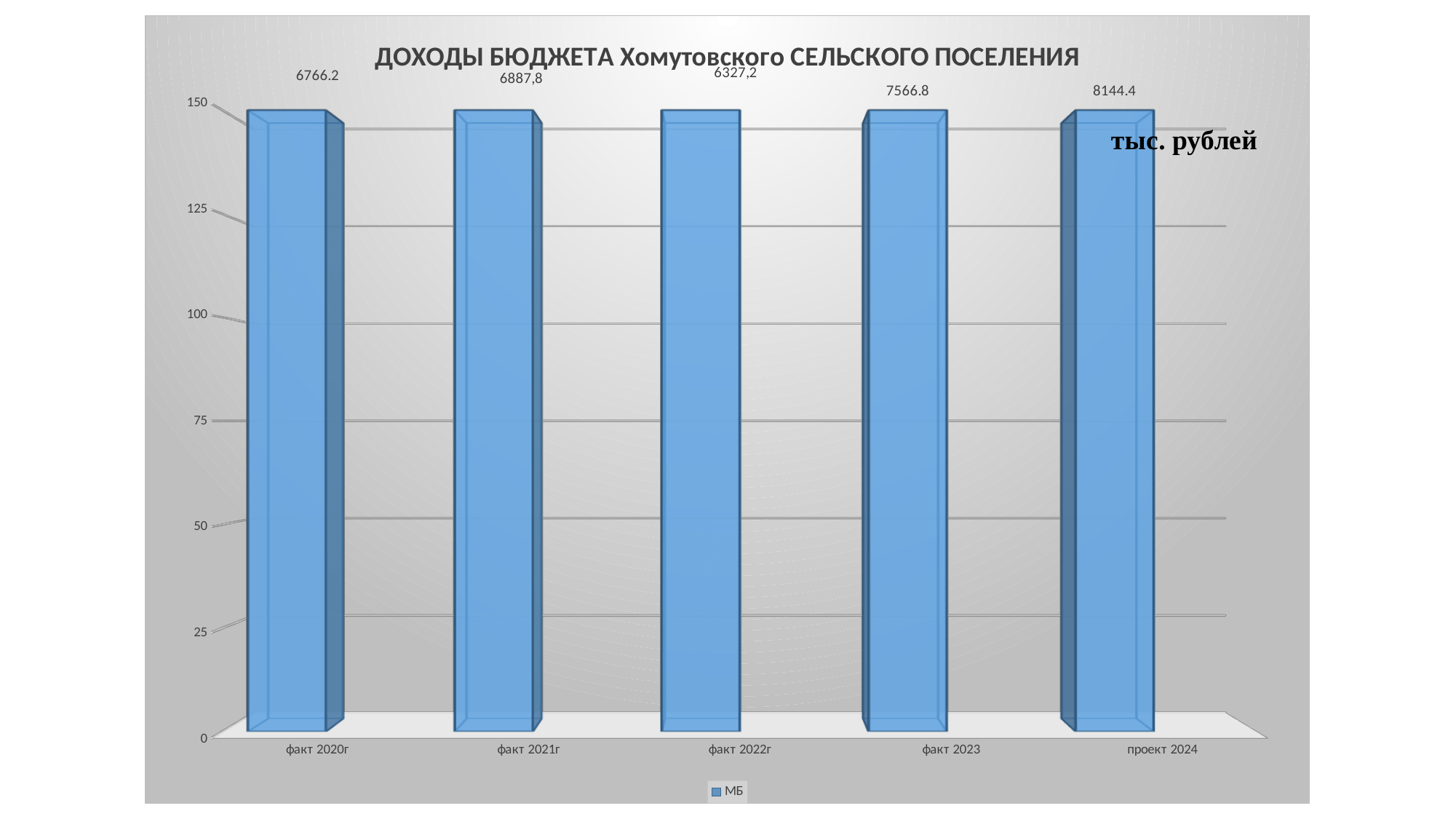
What value is shown for проект 2024? 8144.4 What is the title of the chart? ДОХОДЫ БЮДЖЕТА Хомутовского СЕЛЬСКОГО ПОСЕЛЕНИЯ What value is shown for факт 2022г? 6327,2 How many series does the legend list? 1 What value is shown for факт 2023? 7566.8 What is the difference between the values for проект 2024 and факт 2023? 577.6 Which category has the highest labelled value? проект 2024 What value is shown for факт 2021г? 6887,8 What value is shown for факт 2020г? 6766.2 Which category has the lowest labelled value? факт 2022г Which is larger, the value for факт 2023 or the value for факт 2021г? факт 2023 How many categories are shown on the x axis? 5